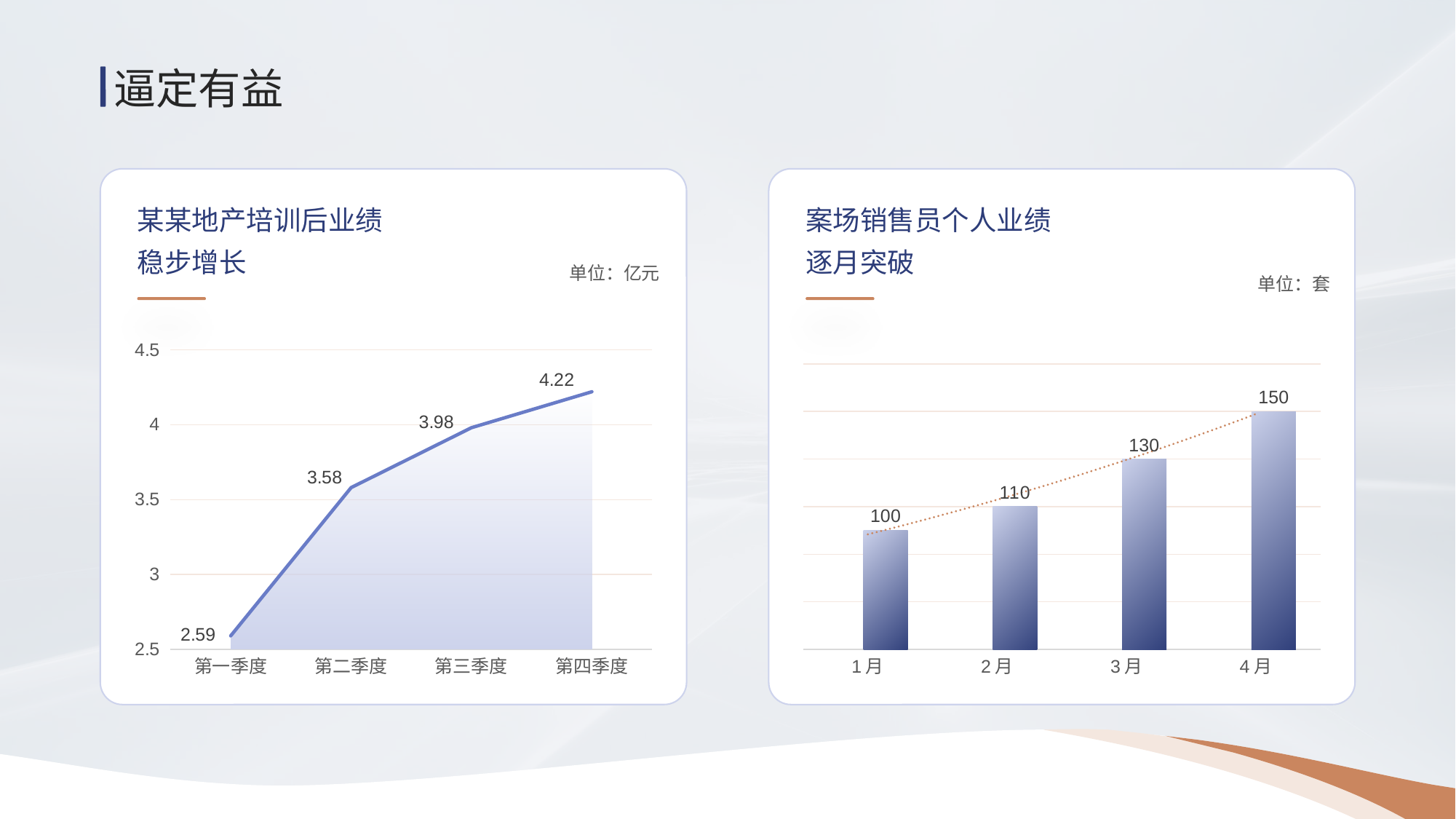
In the left chart (某某地产培训后业绩稳步增长), what is the value for 第二季度? 3.58 In the left chart (某某地产培训后业绩稳步增长), what kind of chart is shown? line chart In the right chart (案场销售员个人业绩逐月突破), what is the value for 3月? 130 In the right chart (案场销售员个人业绩逐月突破), what is the difference between the values for 4月 and 1月? 50 In the right chart (案场销售员个人业绩逐月突破), what kind of chart is shown? bar chart In the right chart (案场销售员个人业绩逐月突破), which month has the highest value? 4月 In the left chart (某某地产培训后业绩稳步增长), which quarter has the highest value? 第四季度 In the left chart (某某地产培训后业绩稳步增长), which quarter has the lowest value? 第一季度 In the left chart (某某地产培训后业绩稳步增长), what is the difference between the values for 第四季度 and 第一季度? 1.63 In the left chart (某某地产培训后业绩稳步增长), do the values rise or fall from 第一季度 to 第四季度? rise In the left chart (某某地产培训后业绩稳步增长), how many quarters are plotted? 4 In the right chart (案场销售员个人业绩逐月突破), what unit is stated for the values? 套